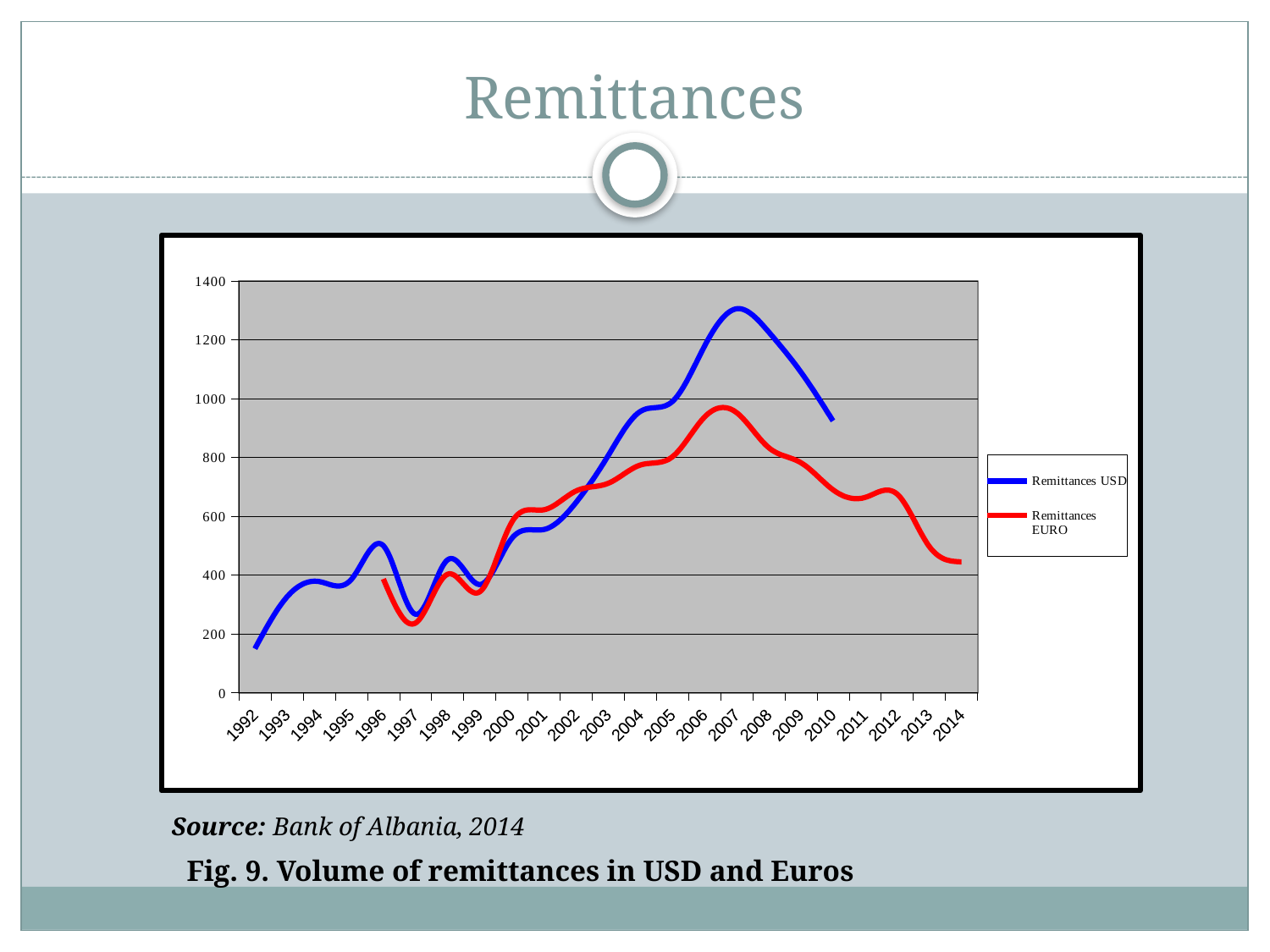
Which series has the larger value in 2007, Remittances USD or Remittances EURO? Remittances USD Which series is drawn in blue? Remittances USD What is the title of the figure given below the chart? Fig. 9. Volume of remittances in USD and Euros How many series does the legend list? 2 Is the value for Remittances USD in 1992 greater or less than 200? less In which year does the Remittances EURO series reach its highest value? 2007 How many years are labelled on the x axis? 23 In which year does the Remittances USD series reach its highest value? 2007 What kind of chart is shown on the slide? line chart Is the value for Remittances EURO in 2007 greater or less than 1000? less Is the value for Remittances USD in 2007 greater or less than 1200? greater Does the Remittances EURO series rise or fall between 2007 and 2014? fall